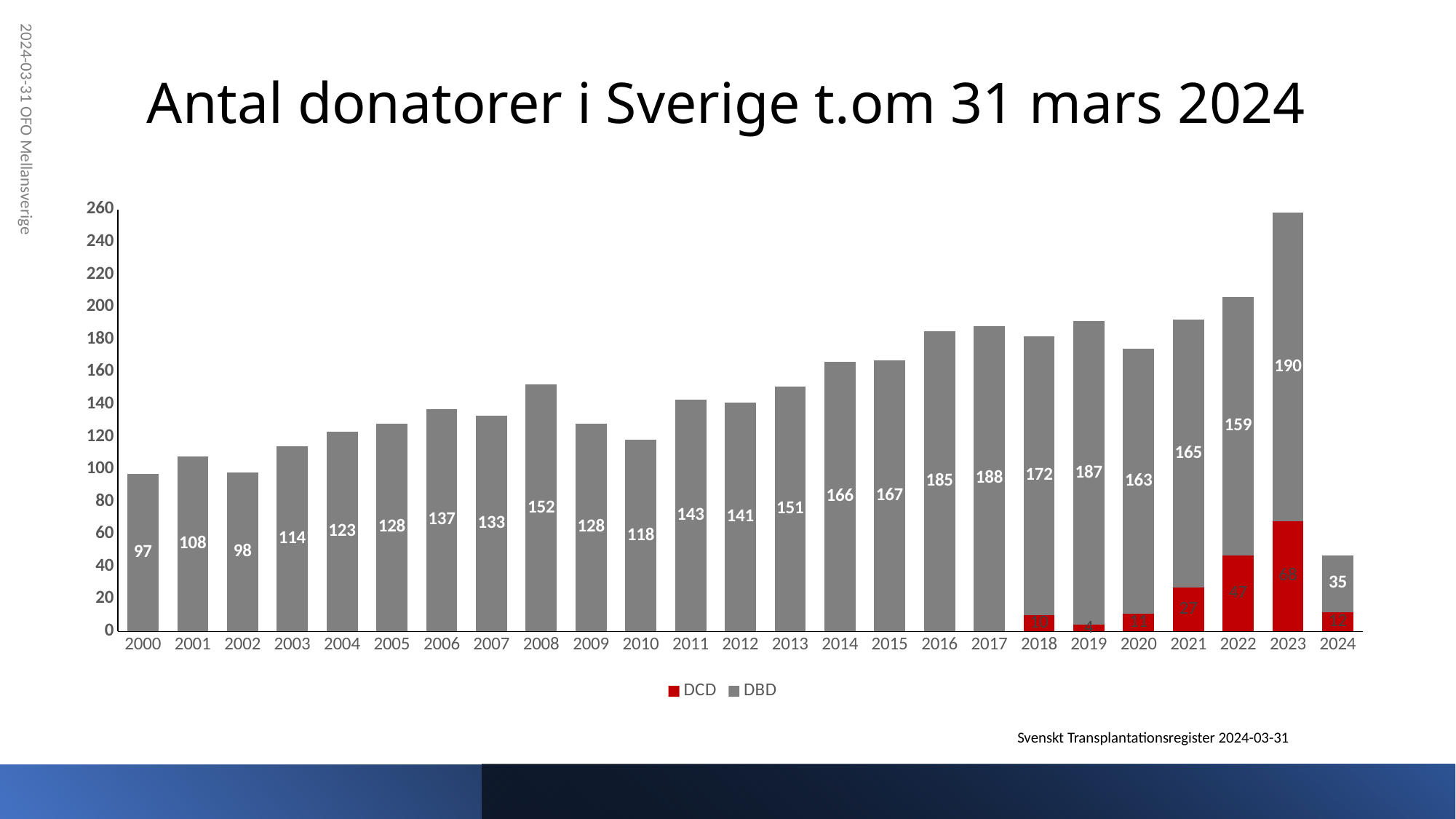
Is the total height of the 2023 bar greater or less than 240? greater What colour represents the DCD series in the legend? Red What is the difference between the DBD value for 2017 and the DBD value for 2000? 91 Among the years with a DCD label, which year has the lowest DCD value? 2019 How many years are shown on the x axis? 25 What is the DCD value for 2022? 47 What is the DBD value for 2008? 152 What kind of chart is shown on the slide? Stacked bar chart What is the total of the stacked bar for 2023 (DCD plus DBD)? 258 Which is larger, the DBD value for 2008 or the DBD value for 2009? 2008 How many series does the legend list? 2 Which year has the highest DBD value? 2023